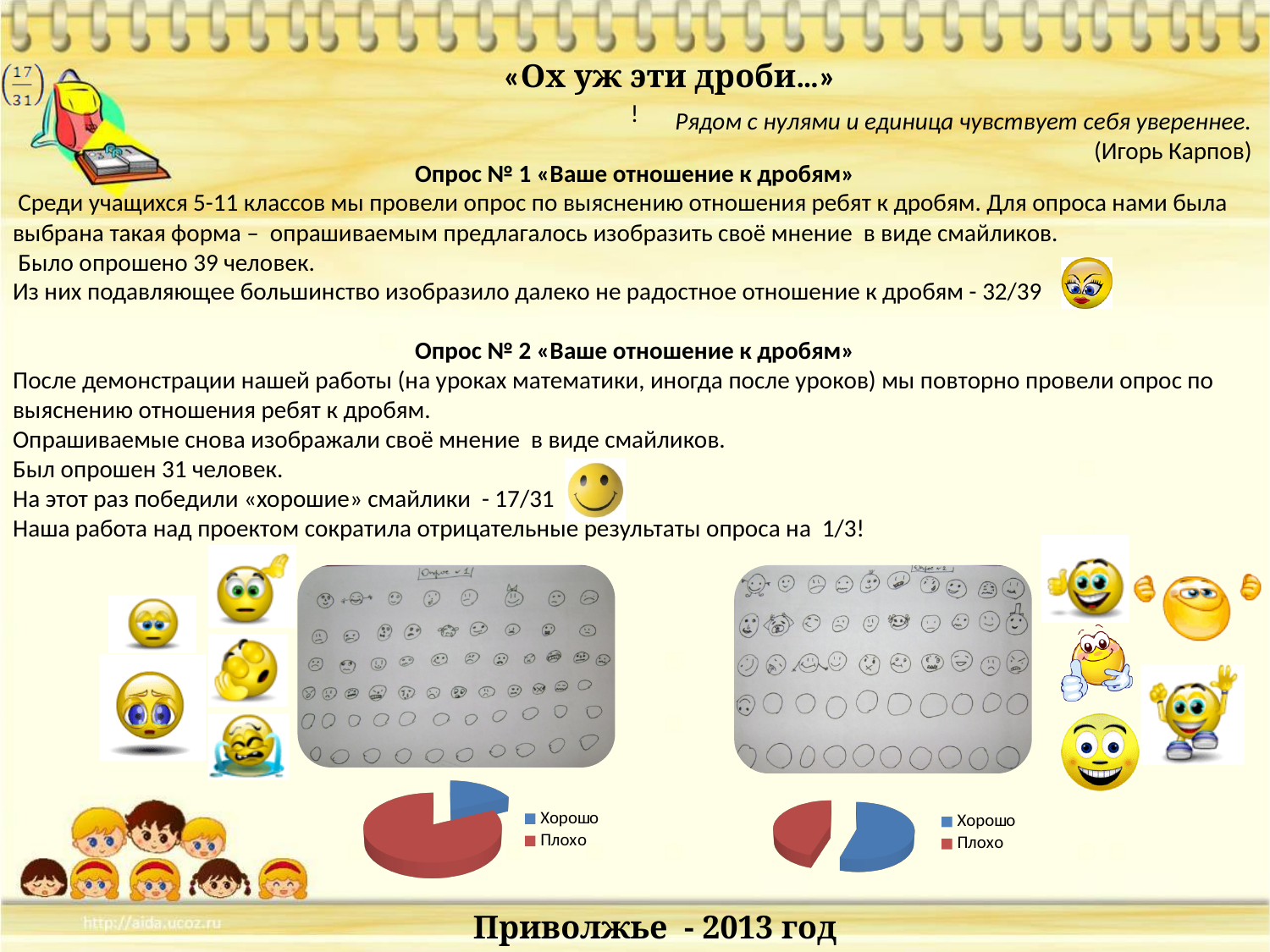
How many slices does the left pie chart have? 2 How many entries does the legend of the left pie chart list? 2 In the left pie chart, which slice is larger, Хорошо or Плохо? Плохо In the left pie chart, what colour is the Плохо slice? red In the right pie chart, which slice is larger, Хорошо or Плохо? Хорошо What are the legend entries of the right pie chart? Хорошо, Плохо What kind of chart is the left chart at the bottom of the slide? pie chart In the left pie chart, which category has the smallest slice? Хорошо In the left pie chart, which category has the largest slice? Плохо What kind of chart is the right chart at the bottom of the slide? pie chart How many slices does the right pie chart have? 2